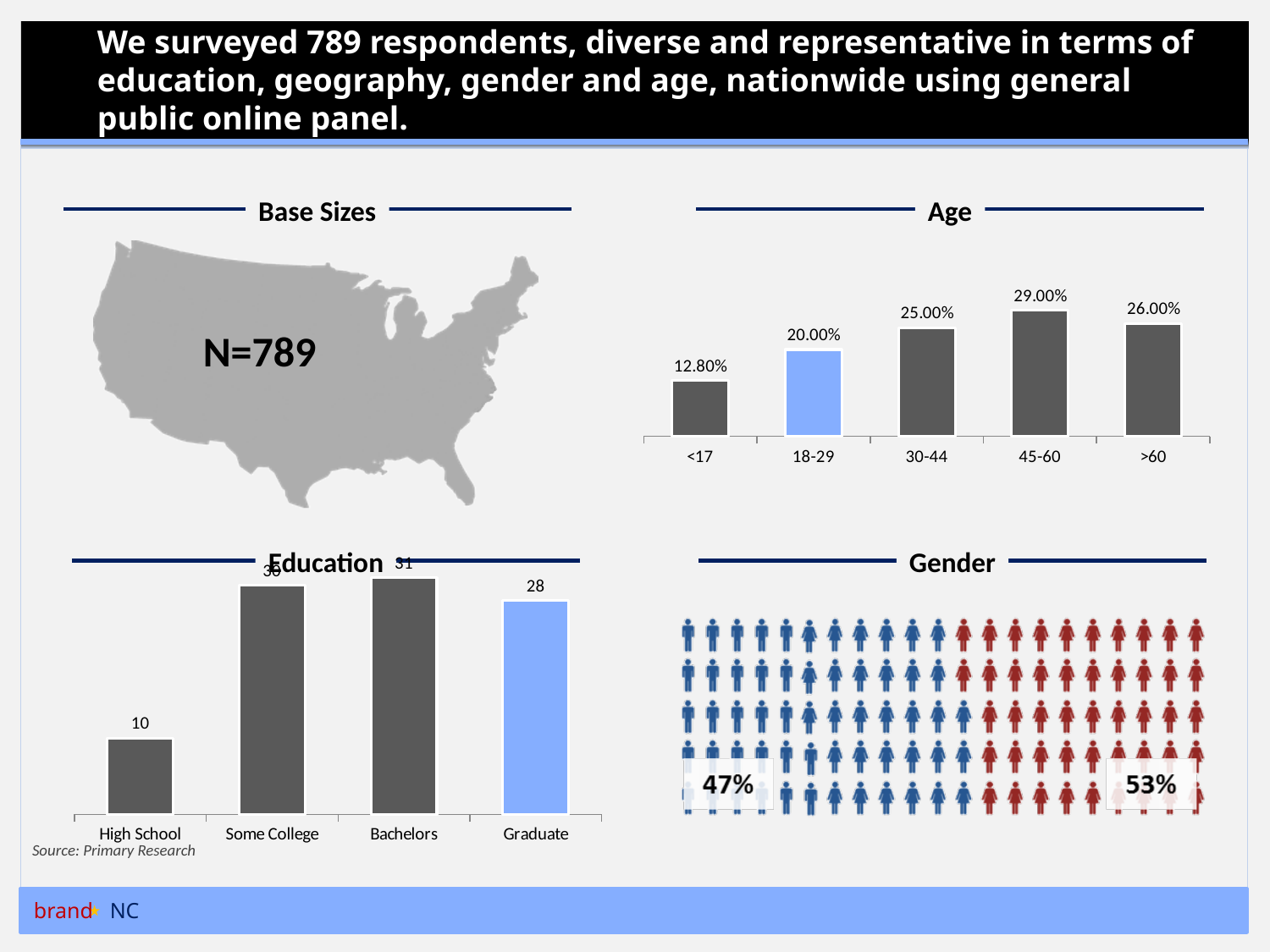
In the Age chart, which is larger: the value for >60 or the value for 30-44? >60 In the Age chart, what is the difference between the 30-44 and 18-29 values? 5.00% In the Age chart, what is the value for the <17 group? 12.80% In the Age chart, which age group has the highest share of respondents? 45-60 In the Education chart, which category has the lowest value? High School In the Education chart, what is the value for Graduate? 28 In the Age chart, what percentage of respondents are aged 45-60? 29.00% In the Age chart, which age group has the lowest share of respondents? <17 How many age groups are shown in the Age chart? 5 What type of chart is the Age chart? Bar chart In the Education chart, what is the value for High School? 10 In the Education chart, what is the difference between the Bachelors and Graduate values? 3